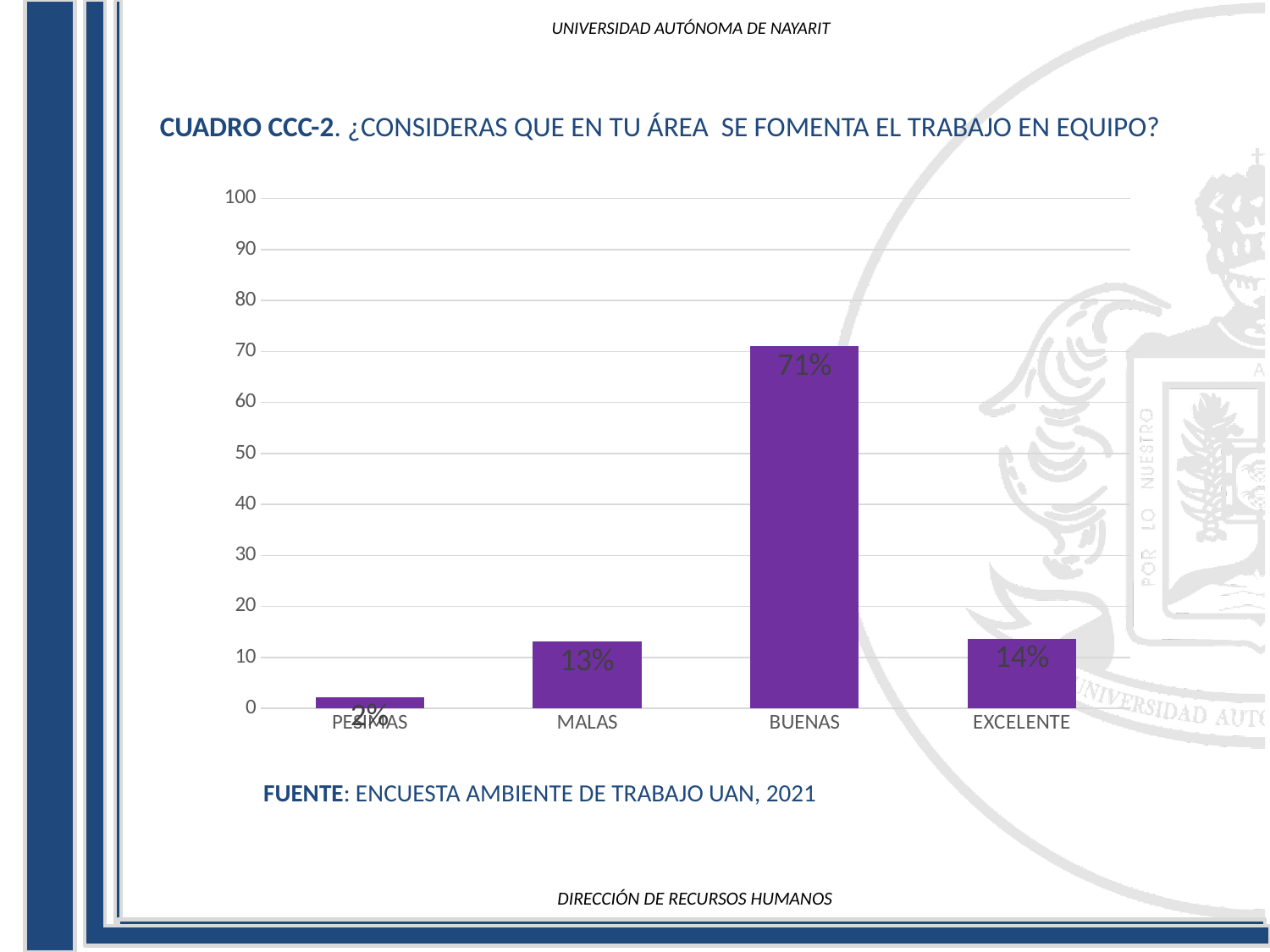
What kind of chart is shown on the slide? bar chart What is the value for PESIMAS? 2% What is the value for MALAS? 13% How many categories are shown on the x axis? 4 What is the value for EXCELENTE? 14% Which category has the highest value? BUENAS Is the value for BUENAS greater or less than 50? greater What is the value for BUENAS? 71% What source is cited below the chart? ENCUESTA AMBIENTE DE TRABAJO UAN, 2021 What is the difference between the values for BUENAS and EXCELENTE? 57% Which is larger, the value for MALAS or the value for EXCELENTE? EXCELENTE Which category has the lowest value? PESIMAS